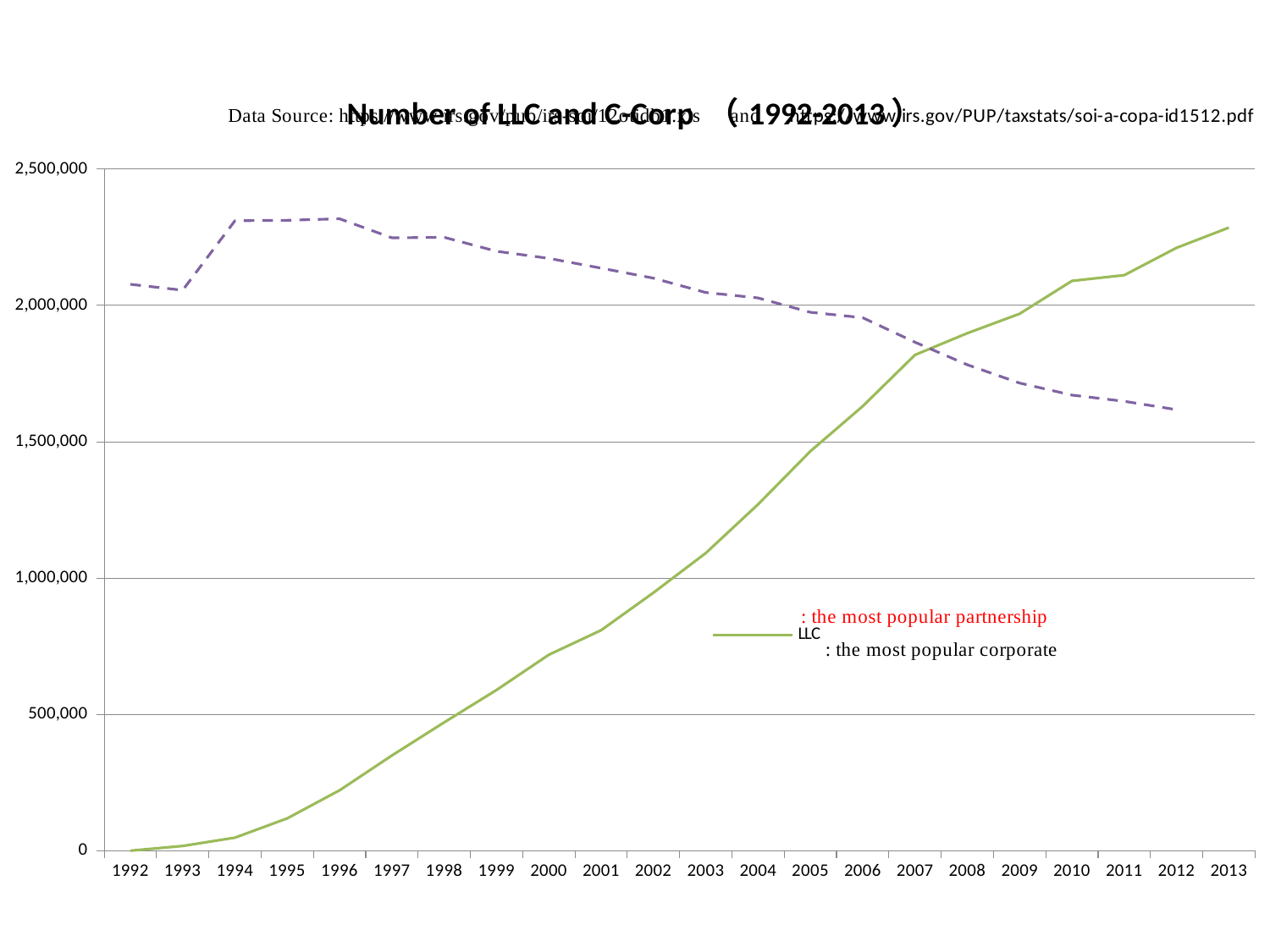
Is the value of the dashed purple line (C Corp) for 2012 greater or less than 1,500,000? greater Is the LLC value for 2013 greater or less than 2,000,000? greater Is the LLC value for 1997 greater or less than 500,000? less What kind of chart is shown on the slide? Line chart Does the LLC line rise or fall from 1992 to 2013? Rises In 2010, which is larger: the LLC value or the dashed purple line (C Corp) value? LLC Which series is drawn as a solid green line in the chart? LLC In 2000, which is larger: the LLC value or the dashed purple line (C Corp) value? C Corp (dashed line) How many years are labelled along the x axis of the chart? 22